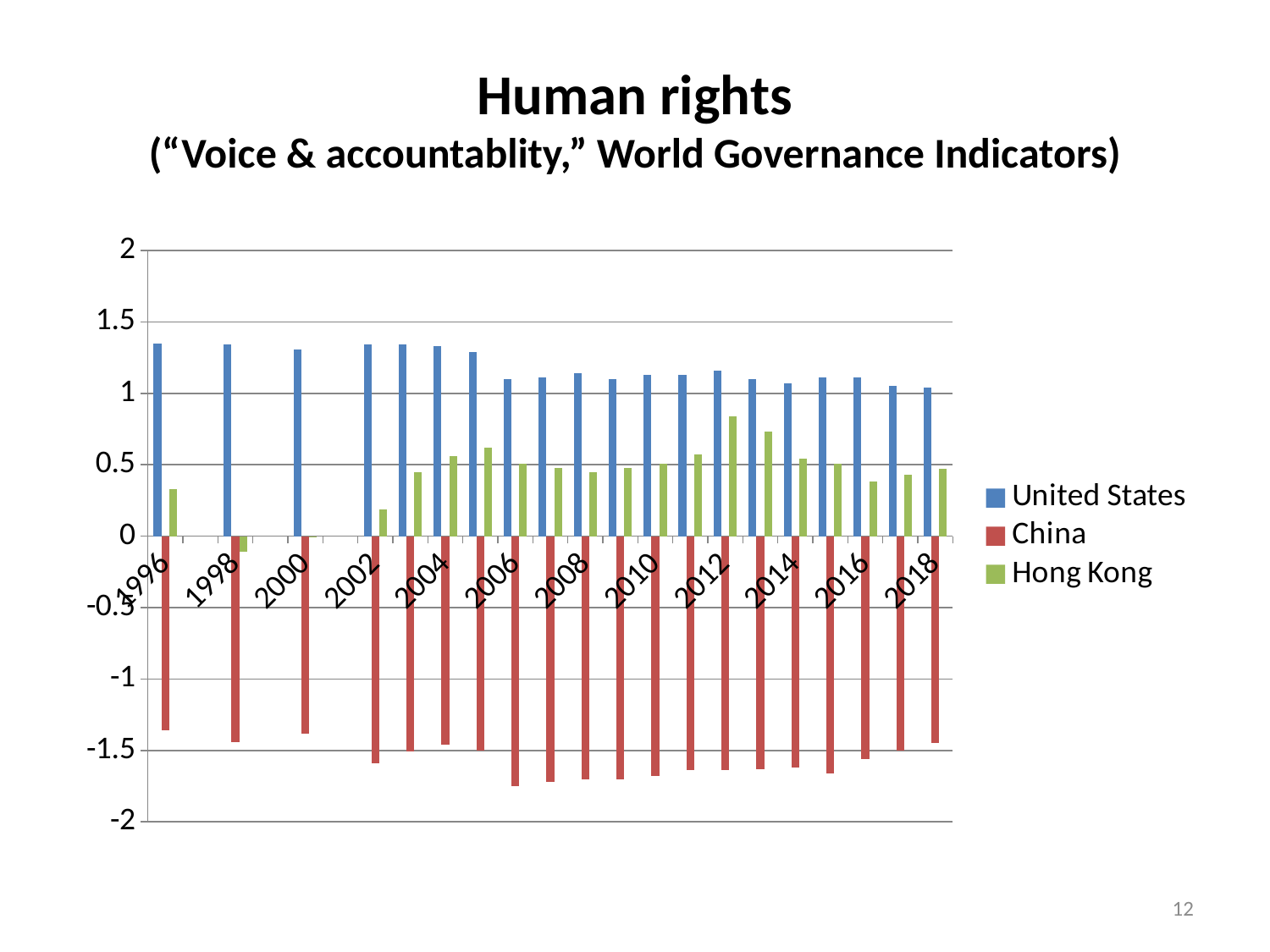
Is the value for United States in 1996 greater or less than 1? greater What kind of chart is shown on the slide? bar chart How many series does the legend list? 3 Is the value for China in 2006 greater or less than -1.5? less Which series has the highest values throughout the chart? United States Which series has the lowest values throughout the chart? China Which colour represents China in the chart? red Is the value for Hong Kong in 2002 greater or less than 0.5? less Which is larger in 2010, the value for United States or the value for Hong Kong? United States Do the values for United States generally rise or fall from 1996 to 2018? fall